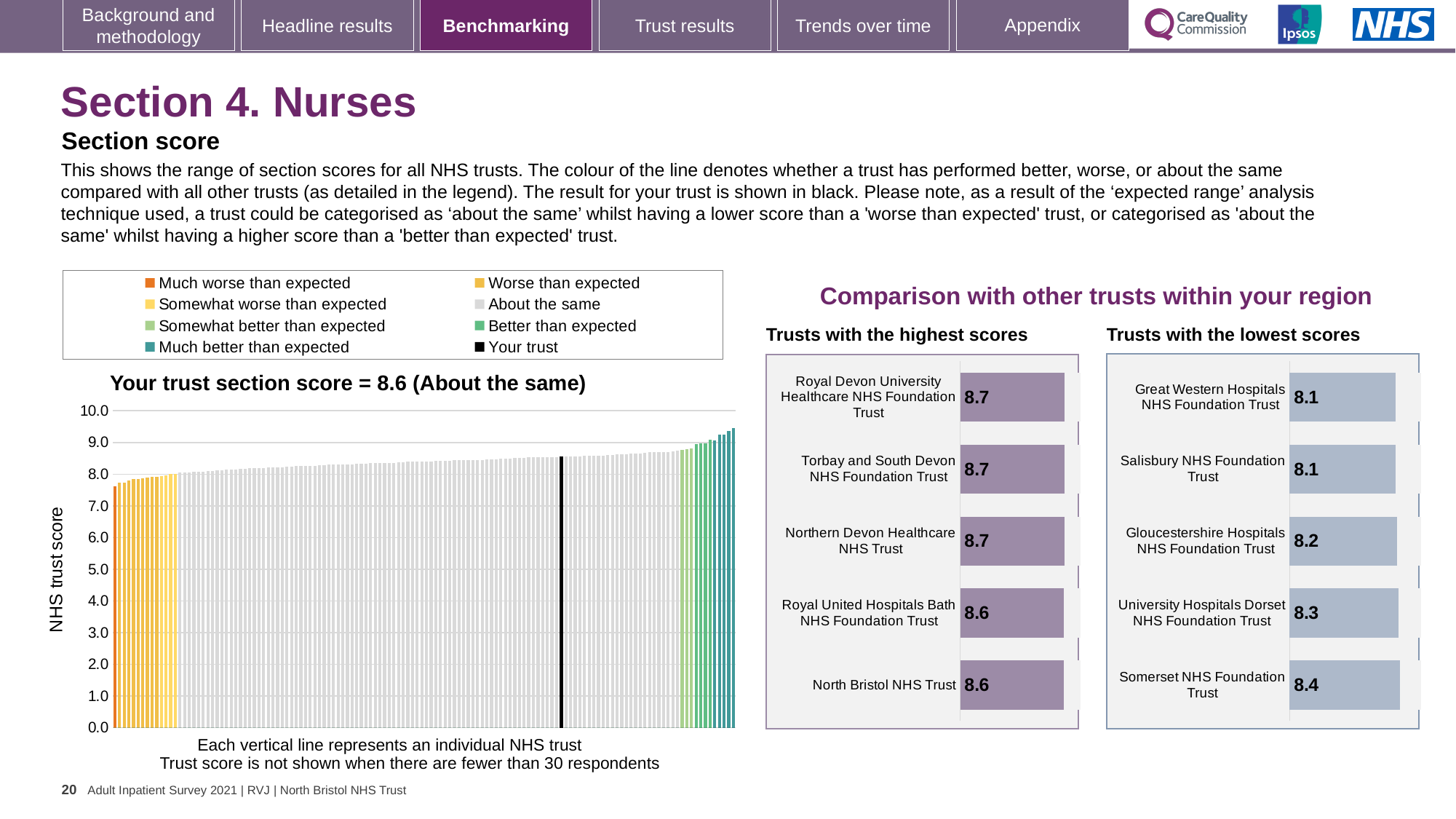
On the 'Trusts with the highest scores' chart, what is the score for Royal United Hospitals Bath NHS Foundation Trust? 8.6 What kind of chart is the 'Your trust section score' chart on the left of the slide? bar chart On the 'Trusts with the highest scores' chart, what is the difference between the scores of Royal Devon University Healthcare NHS Foundation Trust and North Bristol NHS Trust? 0.1 What is the y-axis label of the 'Your trust section score' chart? NHS trust score On the 'Trusts with the lowest scores' chart, what is the score for Gloucestershire Hospitals NHS Foundation Trust? 8.2 On the 'Trusts with the highest scores' chart, how many trusts are shown? 5 On the 'Trusts with the lowest scores' chart, which trust has the highest score? Somerset NHS Foundation Trust On the 'Your trust section score' chart, do the bars rise or fall from left to right? rise On the 'Trusts with the highest scores' chart, what is the score for Northern Devon Healthcare NHS Trust? 8.7 How many entries does the legend above the 'Your trust section score' chart list? 8 On the 'Trusts with the lowest scores' chart, which has the larger score: University Hospitals Dorset NHS Foundation Trust or Salisbury NHS Foundation Trust? University Hospitals Dorset NHS Foundation Trust On the 'Your trust section score' chart, what is the section score for your trust? 8.6